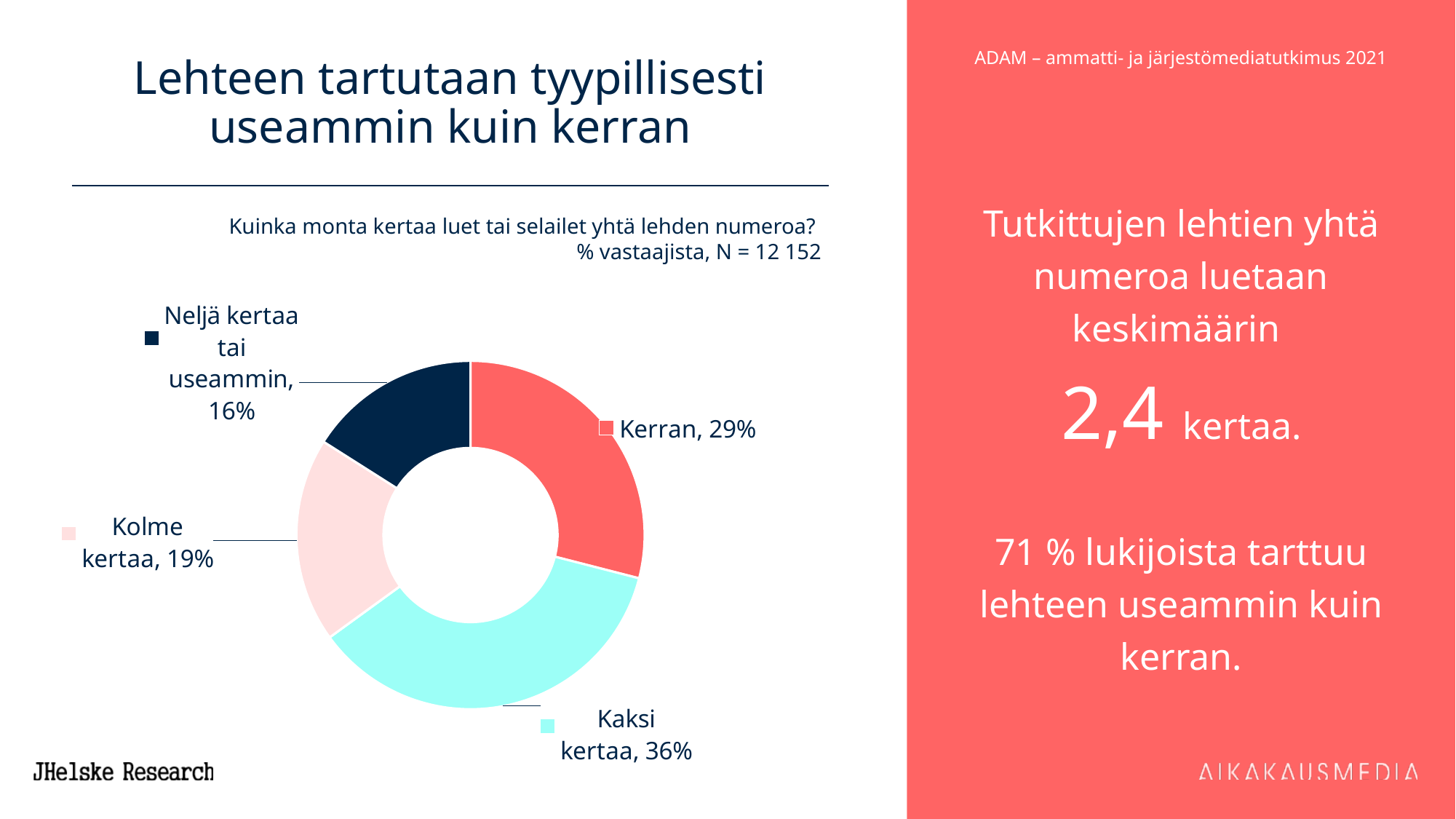
What percentage of respondents read a single issue twice (Kaksi kertaa)? 36% What percentage of respondents read a single issue three times (Kolme kertaa)? 19% What is the combined share of respondents who read an issue more than once (Kaksi kertaa, Kolme kertaa, Neljä kertaa tai useammin)? 71% Which category has the largest share of respondents? Kaksi kertaa Which is larger, the share for Kolme kertaa or the share for Neljä kertaa tai useammin? Kolme kertaa Which category has the smallest share of respondents? Neljä kertaa tai useammin What percentage of respondents read or browse a single issue of a magazine once (Kerran)? 29% How many categories are shown in the chart? 4 What is the sample size (N) stated in the chart subtitle? 12 152 What kind of chart is shown on the slide? Pie chart (doughnut) What percentage of respondents read a single issue four times or more (Neljä kertaa tai useammin)? 16% What is the difference in percentage points between Kaksi kertaa and Kerran? 7